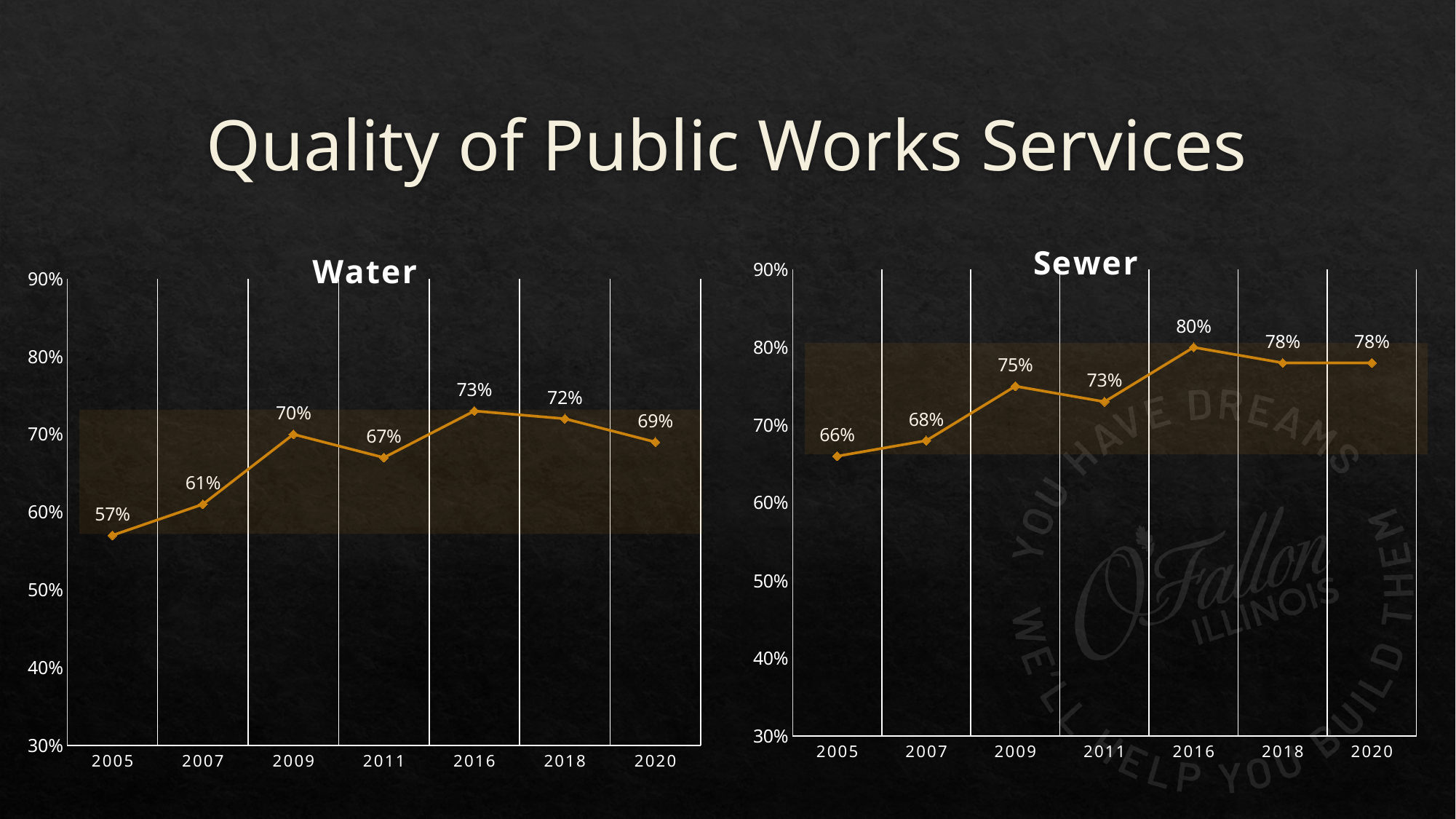
In the Sewer chart, do the values rise or fall from 2005 to 2009? rise What is the title of the chart on the left? Water In the Sewer chart, is the value for 2005 greater or less than 70%? less How many years are plotted in the Water chart? 7 In the Sewer chart, what is the value for 2016? 80% In the Water chart, which is larger, the value for 2009 or the value for 2011? 2009 In the Water chart, what is the difference between the 2016 value and the 2005 value? 16% In the Water chart, which year has the highest value? 2016 What kind of chart is the Sewer chart? line chart In the Sewer chart, which year has the lowest value? 2005 In the Water chart, what is the value for 2005? 57% In the Sewer chart, what is the difference between the 2016 value and the 2011 value? 7%